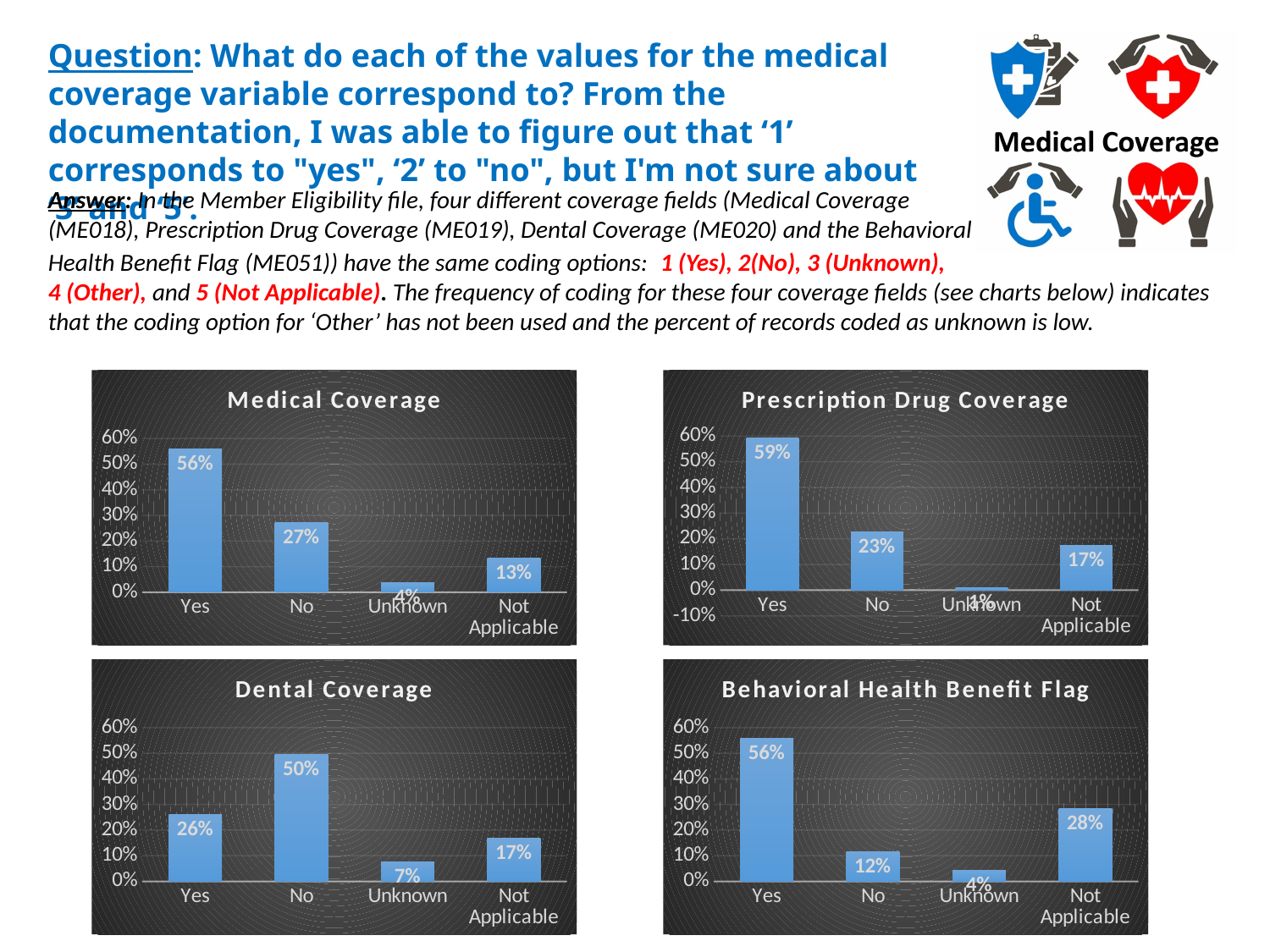
How many categories are shown in the Prescription Drug Coverage chart? 4 In the Prescription Drug Coverage chart, what is the value for Not Applicable? 17% In the Behavioral Health Benefit Flag chart, which is larger, the value for No or the value for Not Applicable? Not Applicable In the Prescription Drug Coverage chart, which category has the lowest value? Unknown In the Behavioral Health Benefit Flag chart, what is the value for No? 12% In the Dental Coverage chart, is the value for Yes greater or less than 30%? less In the Dental Coverage chart, which category has the highest value? No In the Medical Coverage chart, what is the difference between the values for Yes and No? 29% In the Medical Coverage chart, what is the value for Yes? 56% In the Dental Coverage chart, what is the value for Unknown? 7% What kind of chart is the Behavioral Health Benefit Flag chart? bar chart How many charts are shown on the slide? 4